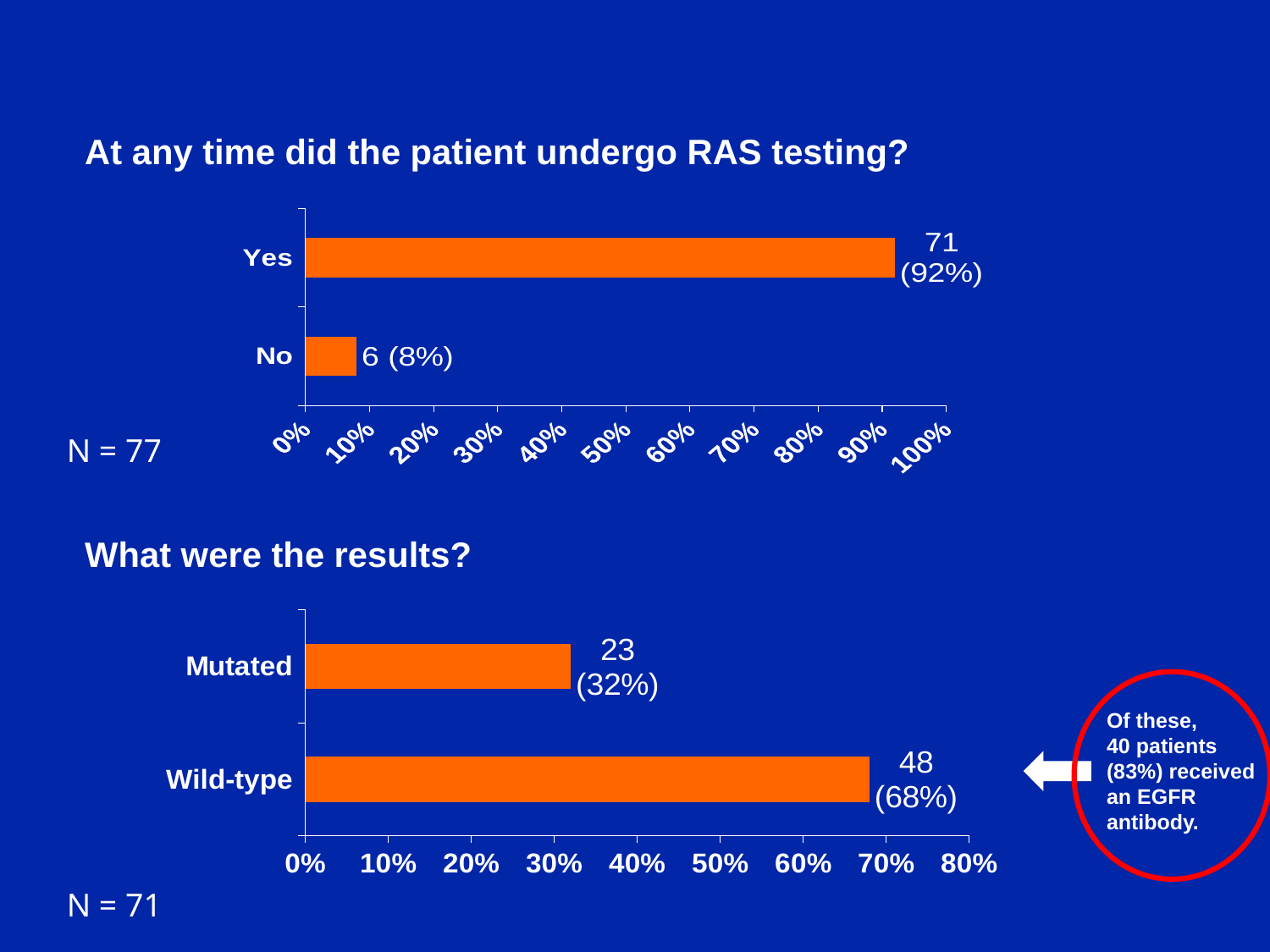
In the chart titled "At any time did the patient undergo RAS testing?", what percentage of patients answered Yes? 92% In the chart titled "At any time did the patient undergo RAS testing?", what is the difference in patient counts between Yes and No? 65 In the chart titled "At any time did the patient undergo RAS testing?", how many categories are shown? 2 In the chart titled "What were the results?", which category has the lowest value? Mutated In the chart titled "At any time did the patient undergo RAS testing?", how many patients answered No? 6 In the chart titled "At any time did the patient undergo RAS testing?", what is the N shown for the chart? N = 77 In the chart titled "What were the results?", what is the difference in percentage points between Wild-type and Mutated? 36% In the chart titled "What were the results?", is the value for Wild-type greater or less than 60%? greater In the chart titled "What were the results?", what percentage of patients were Wild-type? 68% In the chart titled "At any time did the patient undergo RAS testing?", which category has the highest value? Yes What kind of chart is the chart titled "What were the results?"? Bar chart In the chart titled "What were the results?", how many patients were Mutated? 23